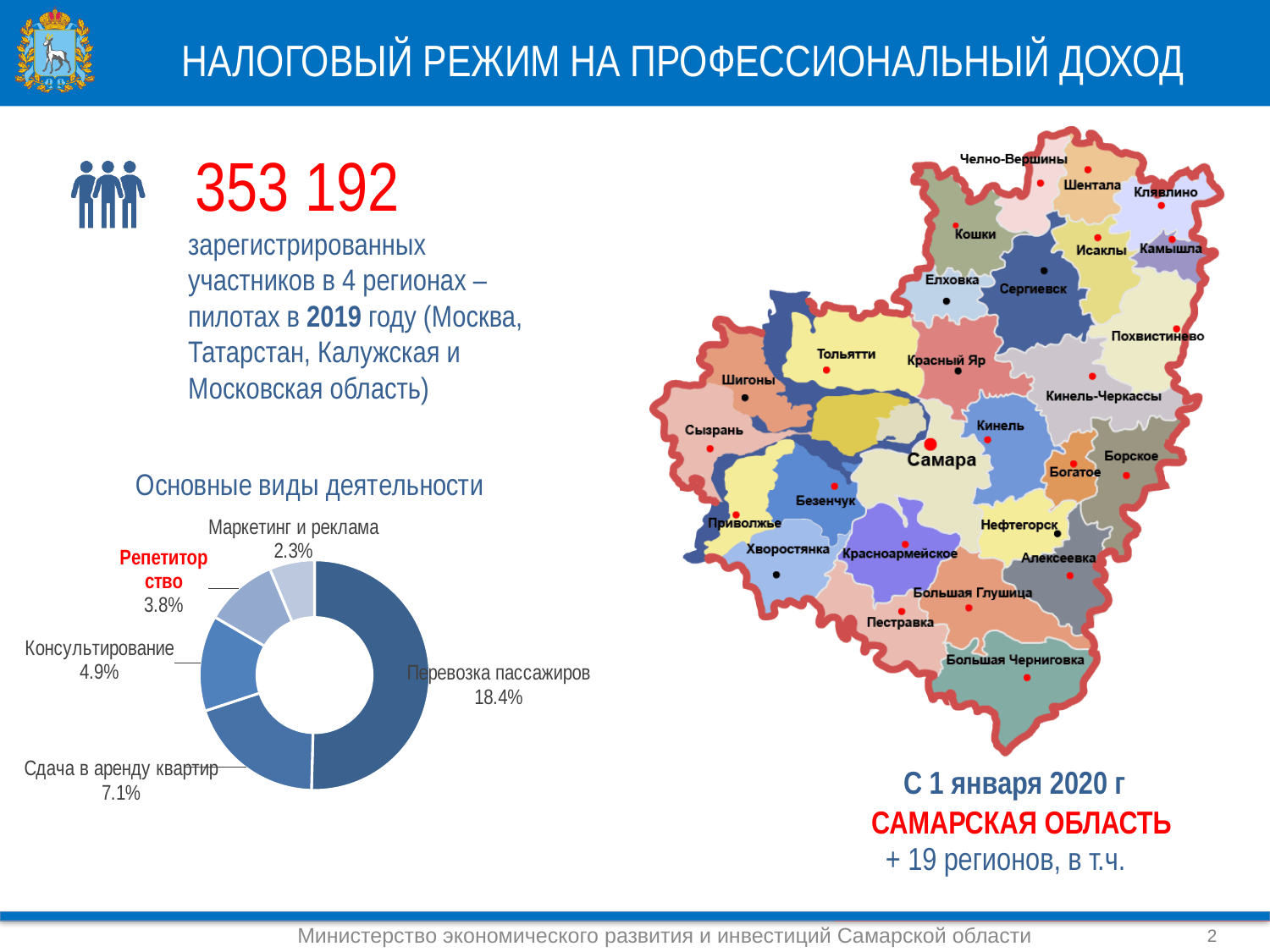
By how many percentage points does Перевозка пассажиров exceed Сдача в аренду квартир? 11.3 percentage points Which labelled activity has the largest share in the chart? Перевозка пассажиров What percentage is shown for Репетиторство? 3.8% Which labelled activity has the smallest share in the chart? Маркетинг и реклама What type of chart is used to show the main types of activity? Doughnut (pie) chart What is the combined share of Репетиторство and Маркетинг и реклама? 6.1% What percentage is shown for Маркетинг и реклама? 2.3% What is the title of the chart on the slide? Основные виды деятельности What percentage is shown for Сдача в аренду квартир? 7.1% What percentage is shown for Консультирование? 4.9% Which has a larger share: Консультирование or Репетиторство? Консультирование What share does Перевозка пассажиров have in the Основные виды деятельности chart? 18.4%